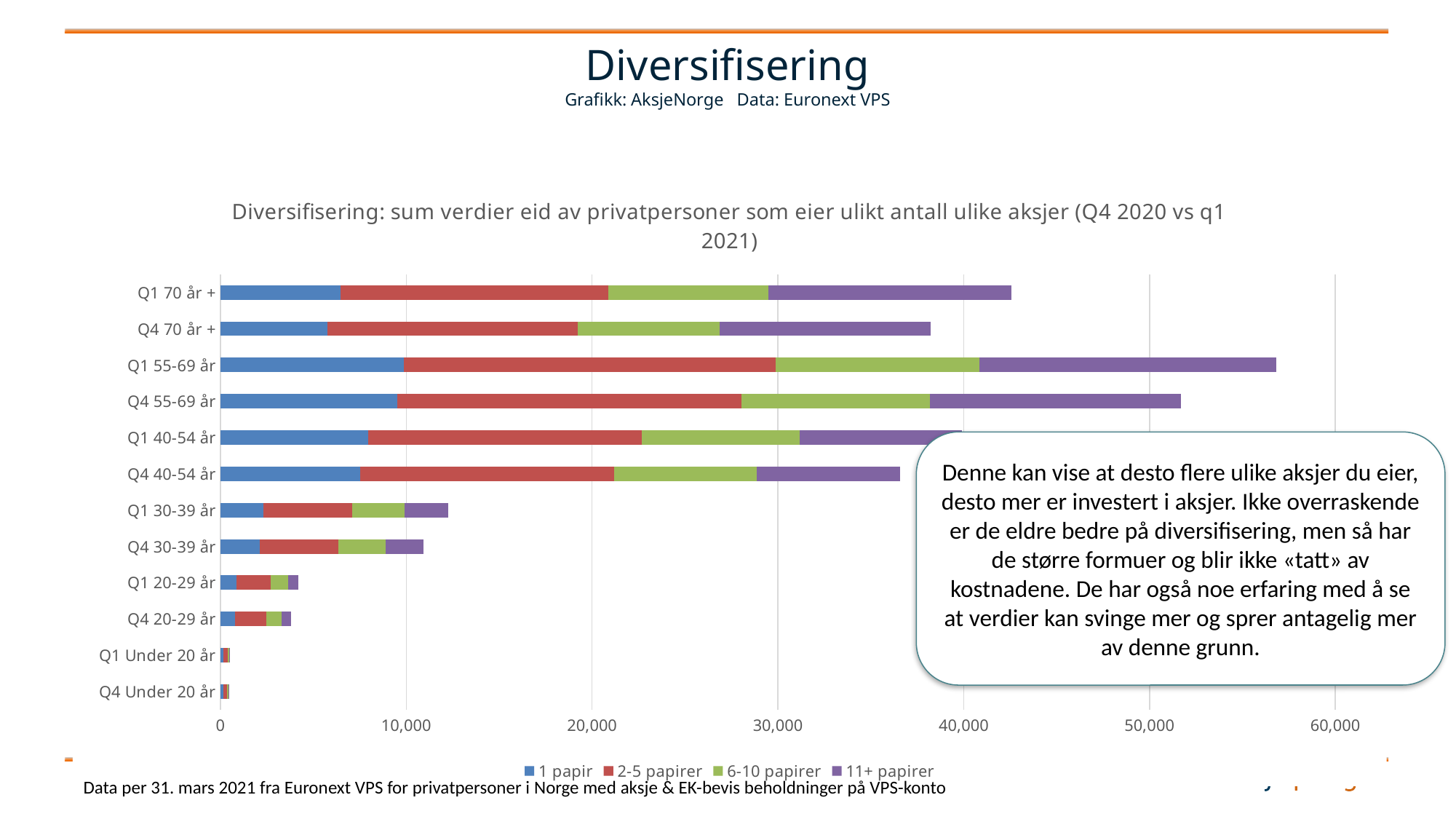
Is the total value for Q4 55-69 år greater or less than 50,000? greater Is the total value for Q4 70 år + greater or less than 40,000? less Which category has the longest total bar? Q1 55-69 år How many categories (bars) are plotted on the chart? 12 What kind of chart is shown on the slide? Stacked bar chart Which has the larger total bar, Q1 70 år + or Q4 70 år +? Q1 70 år + Is the total value for Q1 30-39 år greater or less than 10,000? greater How many series does the legend list? 4 Which has the larger total bar, Q1 55-69 år or Q4 55-69 år? Q1 55-69 år What are the four series listed in the legend? 1 papir, 2-5 papirer, 6-10 papirer, 11+ papirer